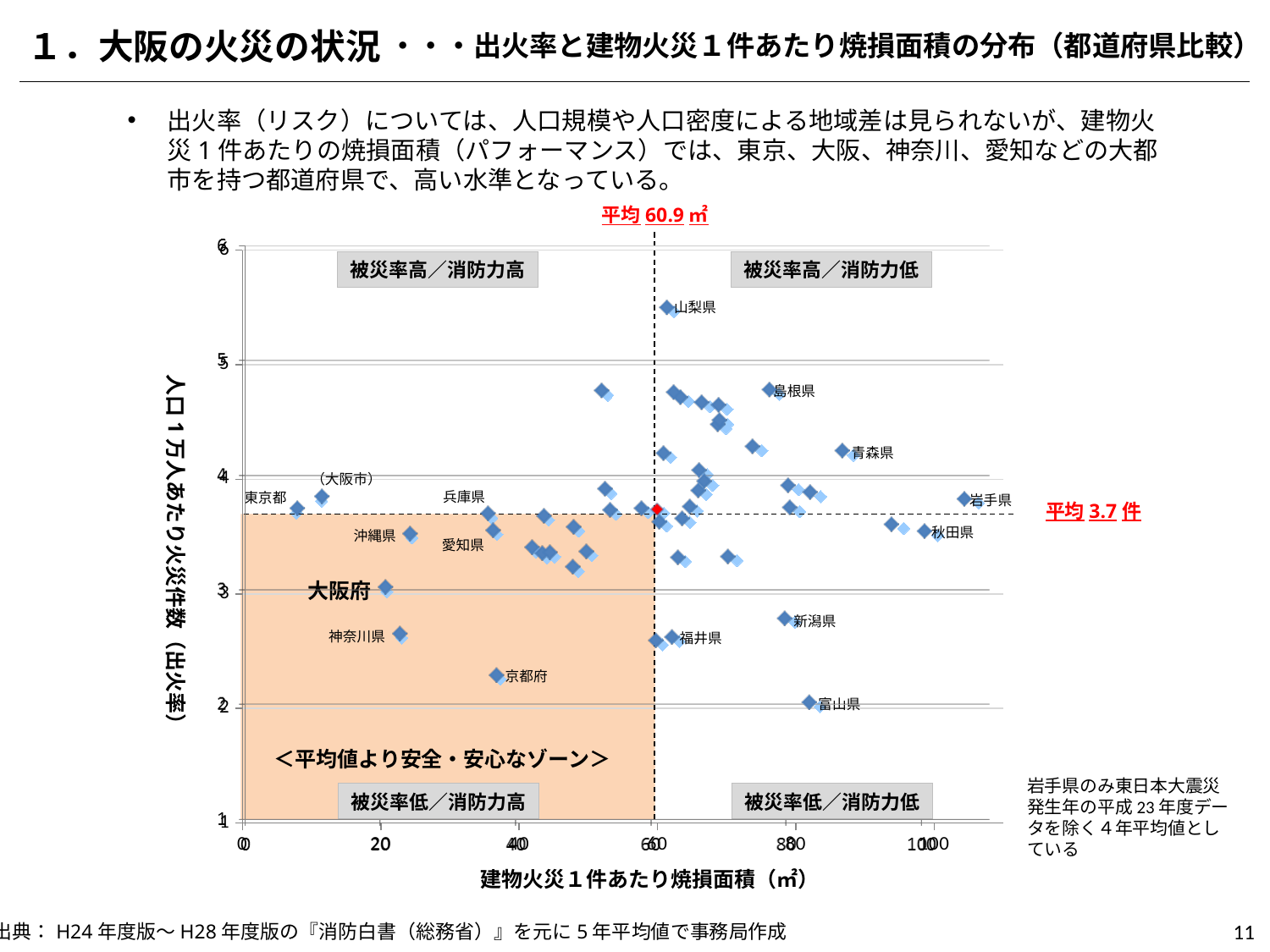
Which has a higher 出火率, 神奈川県 or 京都府? 神奈川県 Which labeled prefecture has the lowest 人口1万人あたり火災件数（出火率）? 富山県 What is the label of the x axis of the chart? 建物火災1件あたり焼損面積（㎡） Which labeled prefecture has the largest 建物火災1件あたり焼損面積? 岩手県 What kind of chart is shown on the slide? scatter chart Is the 出火率 value for 京都府 greater or less than 3? less Is the 建物火災1件あたり焼損面積 value for 東京都 greater or less than 20? less Is the 出火率 value for 山梨県 greater or less than 5? greater Which has a larger 建物火災1件あたり焼損面積, 岩手県 or 秋田県? 岩手県 Which labeled prefecture has the highest 人口1万人あたり火災件数（出火率）? 山梨県 What is the average value of 建物火災1件あたり焼損面積 marked by the vertical dashed line? 60.9 ㎡ What is the average value of 出火率 marked by the horizontal dashed line? 3.7 件